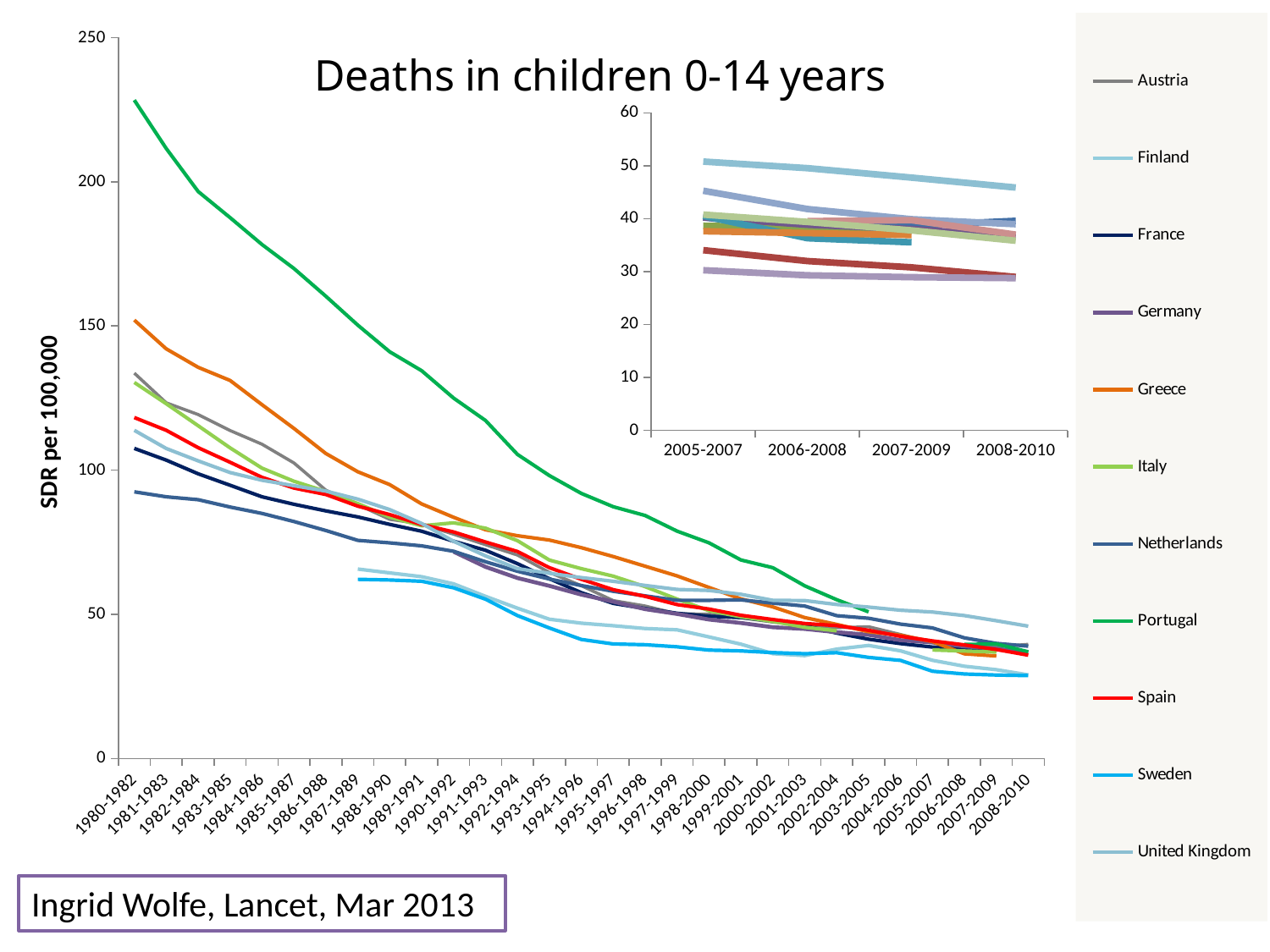
In the main chart, is the value for Greece at 1980-1982 greater or less than 100? greater In the main chart, is the value for Portugal at 1980-1982 greater or less than 200? greater How many periods are shown on the x axis of the main chart? 29 How many series does the legend list? 11 In the main chart, does the Portugal line rise or fall from 1980-1982 to 2003-2005? fall In the main chart, is the value for Sweden at 2008-2010 greater or less than 50? less What is the label on the vertical axis of the main chart? SDR per 100,000 In the main chart, which is larger at 1980-1982: Portugal or Greece? Portugal What kind of chart is the main chart on the slide? line chart What is the title of the chart? Deaths in children 0-14 years How many periods are shown on the x axis of the inset chart? 4 In the main chart, which series has the highest value at 1980-1982? Portugal